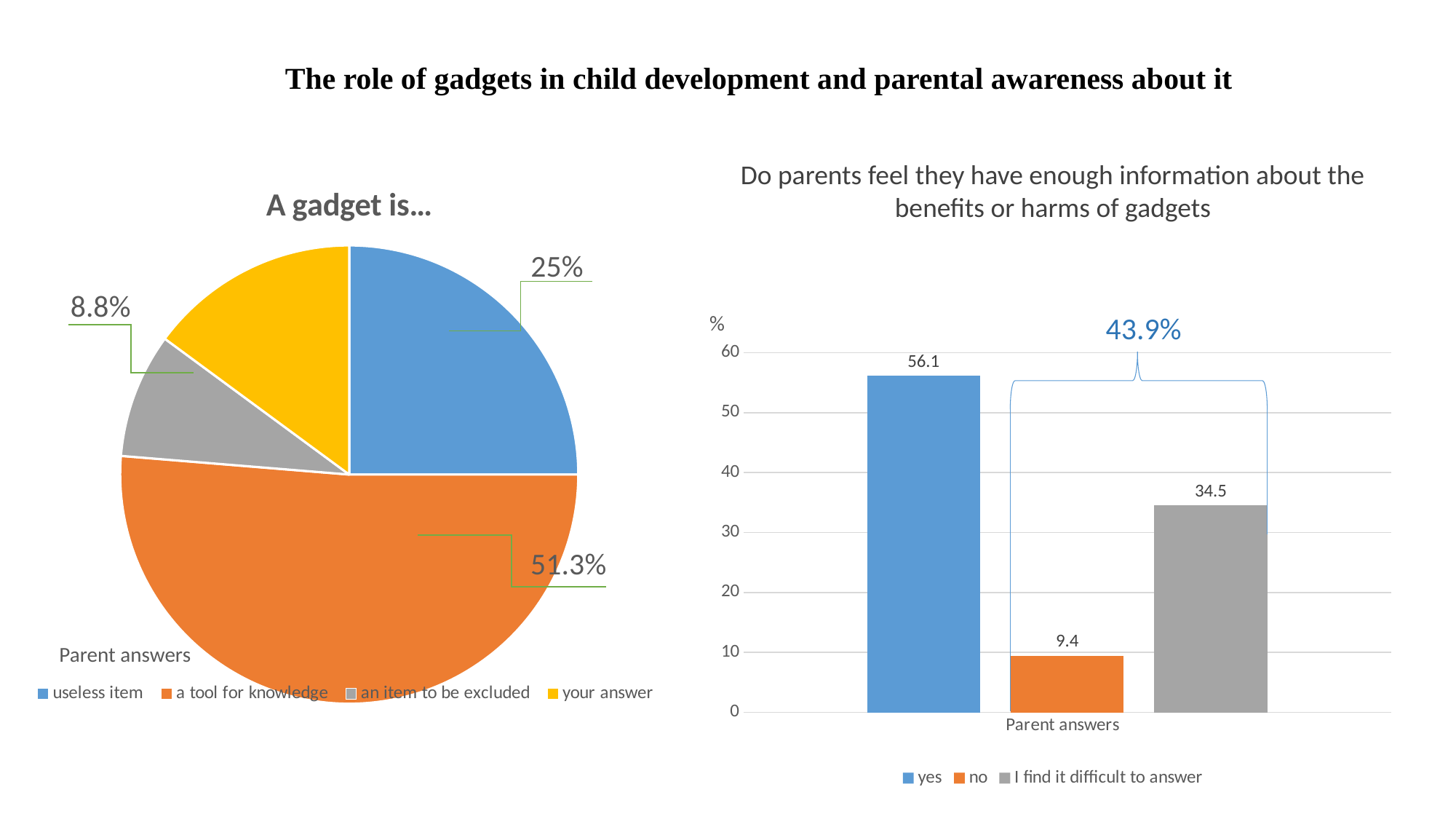
In the pie chart 'A gadget is...', which answer has the smallest slice? an item to be excluded What type of chart is the chart on the right of the slide? bar chart In the bar chart on the right, what is the value for 'no'? 9.4 In the bar chart on the right, what is the value for 'yes'? 56.1 In the pie chart 'A gadget is...', how many categories does the legend list? 4 In the pie chart 'A gadget is...', which answer has the largest slice? a tool for knowledge In the bar chart on the right, what is the value for 'I find it difficult to answer'? 34.5 In the pie chart 'A gadget is...', what share of parent answers is 'an item to be excluded'? 8.8% In the pie chart 'A gadget is...', what share of parent answers is 'useless item'? 25% In the bar chart on the right, which is larger: 'no' or 'I find it difficult to answer'? I find it difficult to answer In the bar chart on the right, what is the difference between the 'yes' and 'no' values? 46.7 In the pie chart 'A gadget is...', what share of parent answers is 'a tool for knowledge'? 51.3%